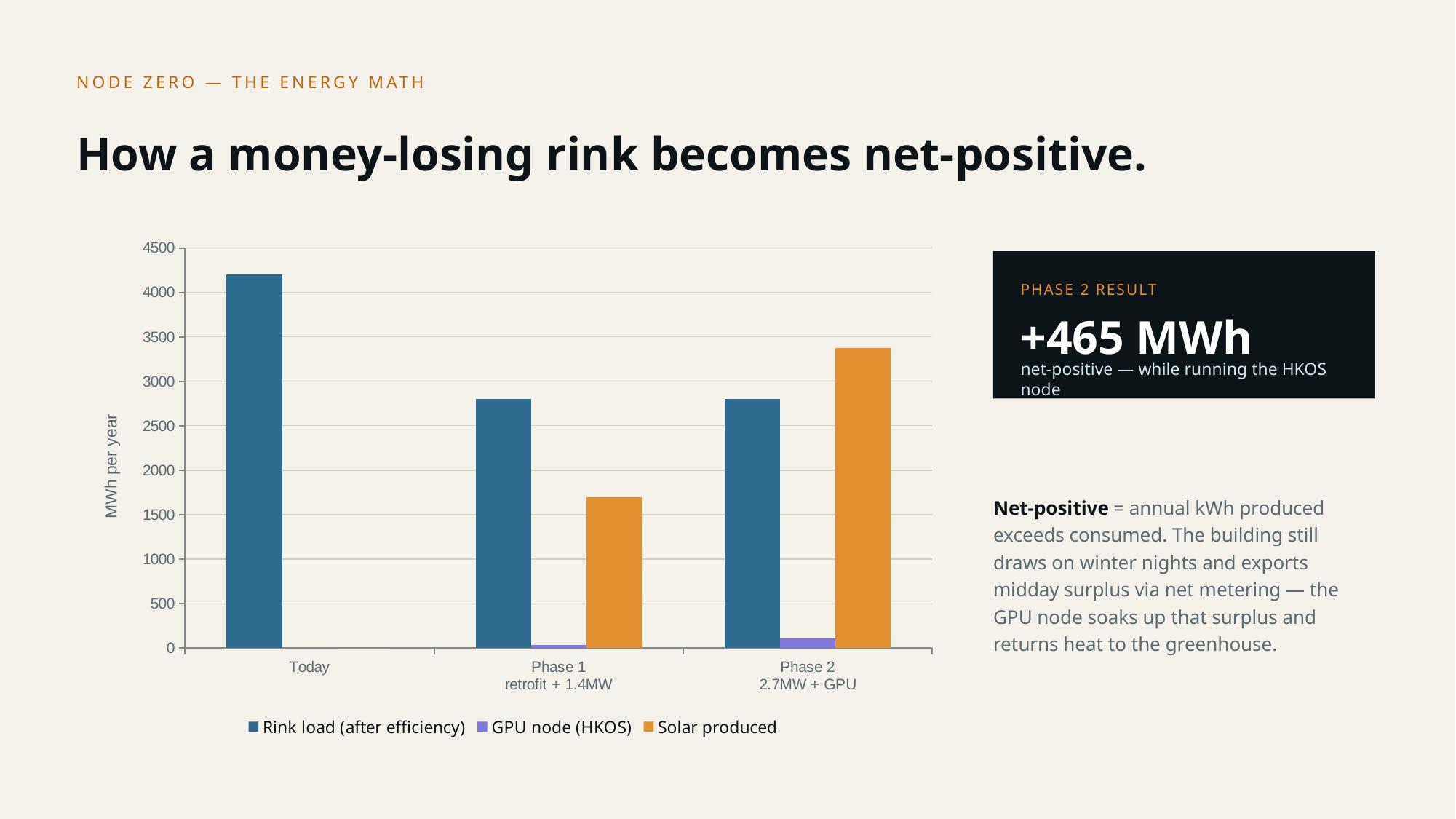
In Phase 1, which is larger: Rink load (after efficiency) or Solar produced? Rink load (after efficiency) Is the Solar produced value for Phase 2 greater or less than 3000? greater Is the Solar produced value for Phase 1 greater or less than 2000? less In Phase 2, which is larger: Solar produced or Rink load (after efficiency)? Solar produced How many series does the chart legend list? 3 Is the Rink load (after efficiency) value for Today greater or less than 4000? greater What is the label on the vertical axis of the chart? MWh per year Which category has the highest Solar produced value? Phase 2 Which category has the highest Rink load (after efficiency) value? Today How many categories are shown on the x axis of the chart? 3 What kind of chart is shown on the slide? bar chart